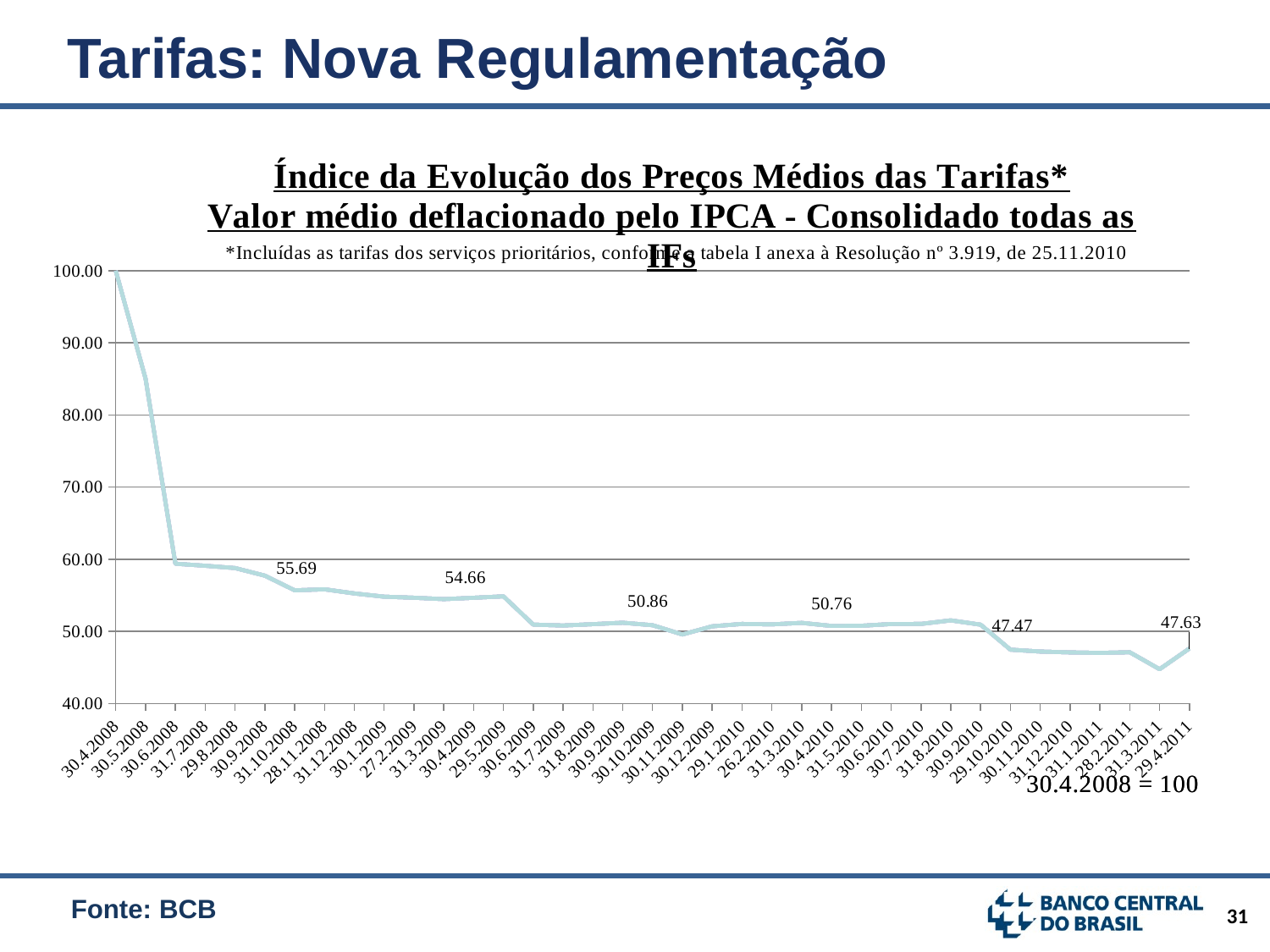
What is the index value at the last point, 29.4.2011? 47.63 What is the labelled index value near 30.10.2009? 50.86 What is the labelled index value near 31.10.2008? 55.69 Is the index value for 31.3.2011 greater or less than 50? less Is the index value for 30.5.2008 greater or less than 80? greater What is the labelled index value near 30.4.2009? 54.66 Which date has the highest index value? 30.4.2008 Does the index generally rise or fall from 30.4.2008 to 29.4.2011? Fall What base value is the index set to on 30.4.2008, according to the note on the chart? 100 What kind of chart is shown on the slide? Line chart What is the difference between the labelled values 55.69 (near 31.10.2008) and 54.66 (near 30.4.2009)? 1.03 What is the labelled index value near 30.4.2010? 50.76